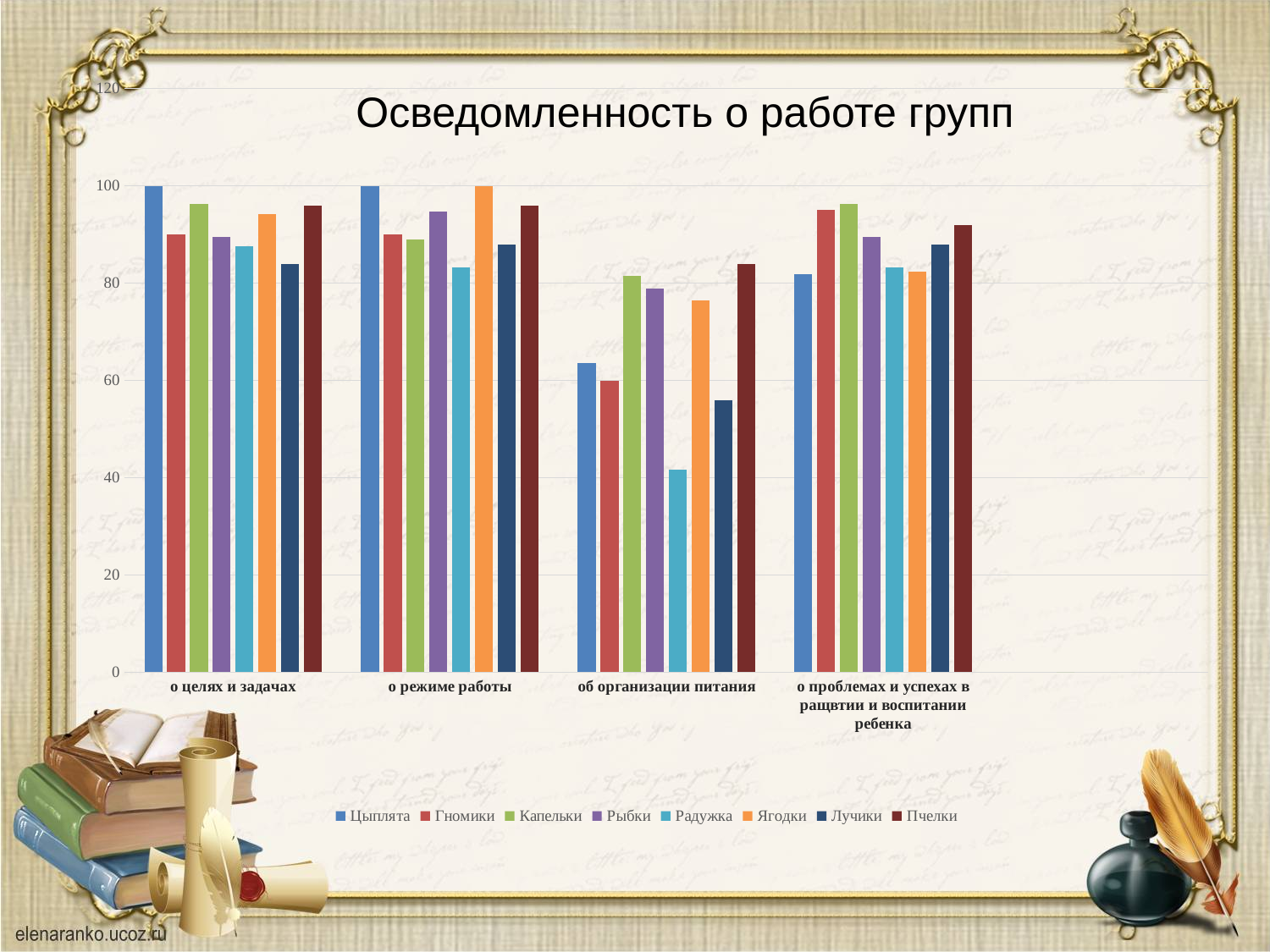
What is the title of the chart? Осведомленность о работе групп Is the value for Ягодки in the category 'об организации питания' greater or less than 80? less In the category 'об организации питания', which is larger: the value for Цыплята or the value for Радужка? Цыплята How many categories are shown on the x axis of the chart? 4 Which series has the lowest value in the category 'об организации питания'? Радужка Is the value for Лучики in the category 'об организации питания' greater or less than 60? less What is the value for Гномики in the category 'об организации питания'? 60 How many series does the legend list? 8 In the category 'о режиме работы', which is larger: the value for Ягодки or the value for Лучики? Ягодки What is the value for Ягодки in the category 'о режиме работы'? 100 What kind of chart is shown on the slide? bar chart What is the value for Цыплята in the category 'о целях и задачах'? 100